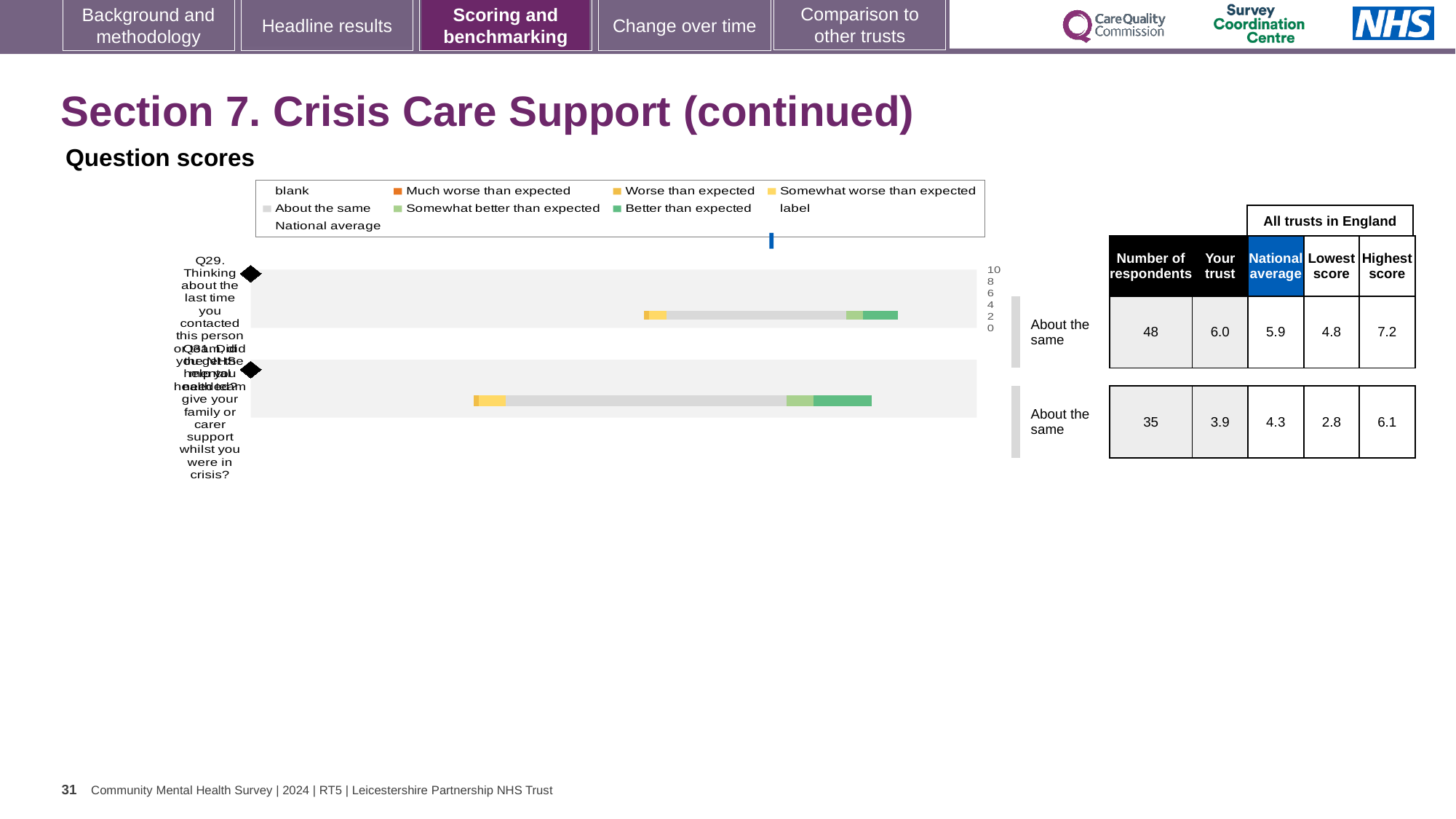
What is the highest score among all trusts in England for Q31? 6.1 What is the national average score for Q31? 4.3 What is the lowest score among all trusts in England for Q29? 4.8 What is the 'Your trust' score for Q29? 6.0 What is the difference between the highest and lowest scores for Q31? 3.3 For Q31, which is larger: the 'Your trust' score or the national average? National average What kind of chart is used to show the question scores on this slide? bar chart How is the trust's result for Q29 categorised relative to other trusts? About the same How many questions are plotted in the question scores chart? 2 How many respondents answered Q29? 48 Which question has the higher 'Your trust' score, Q29 or Q31? Q29 What is the difference between the 'Your trust' score and the national average for Q29? 0.1